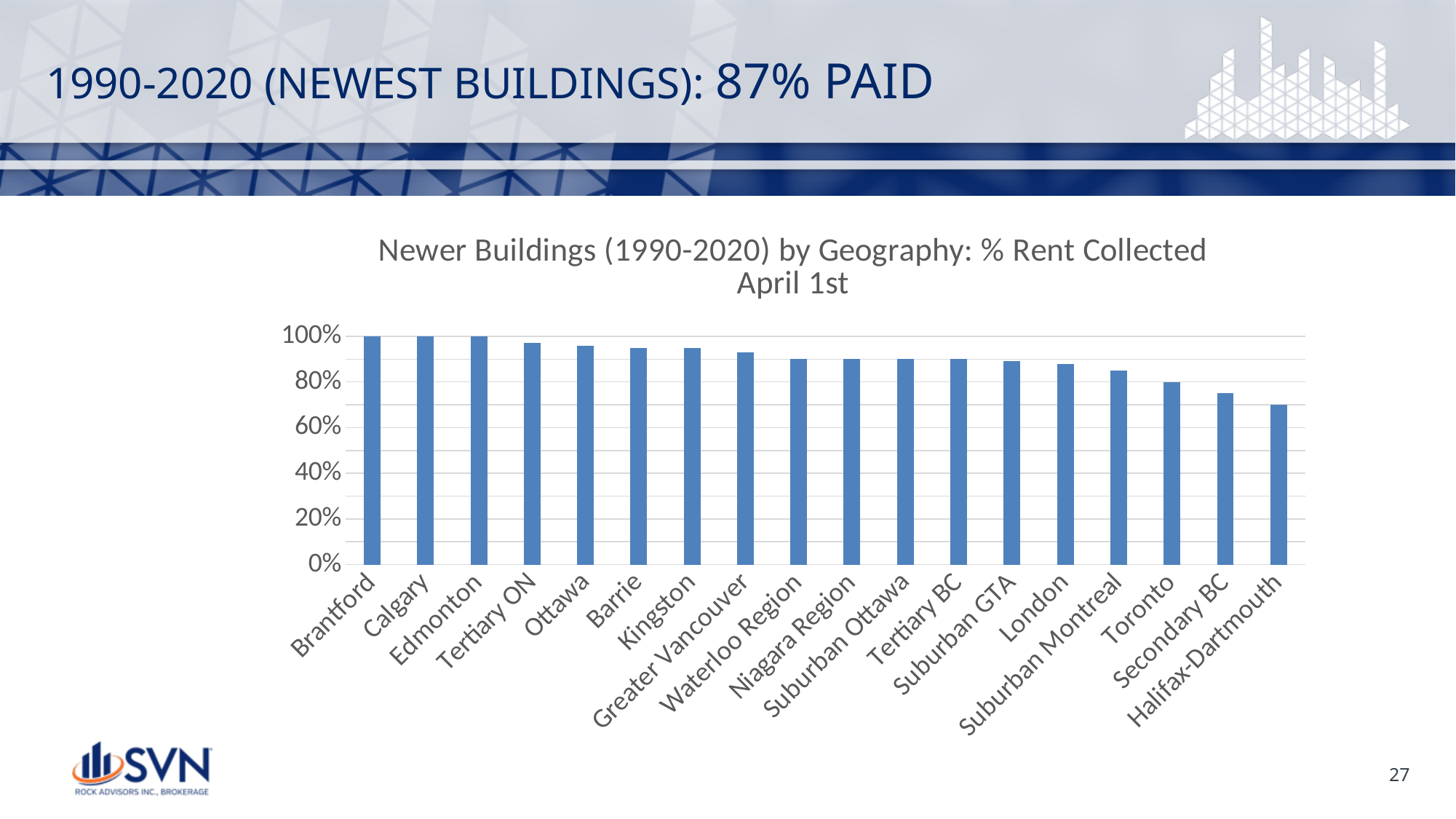
How many geographies are plotted in the chart? 18 What is the % rent collected for Brantford? 100% What kind of chart is shown on the slide? Bar chart Is the value for Ottawa greater or less than 90%? greater Which has a higher % rent collected, Toronto or Halifax-Dartmouth? Toronto Is the value for Suburban Montreal greater or less than 80%? greater Which geography has the lowest % rent collected? Halifax-Dartmouth Is the value for Halifax-Dartmouth greater or less than 60%? greater Do the values generally rise or fall moving from left to right along the x axis? Fall How many geographies have a bar reaching 100%? 3 What is the title of the chart? Newer Buildings (1990-2020) by Geography: % Rent Collected April 1st